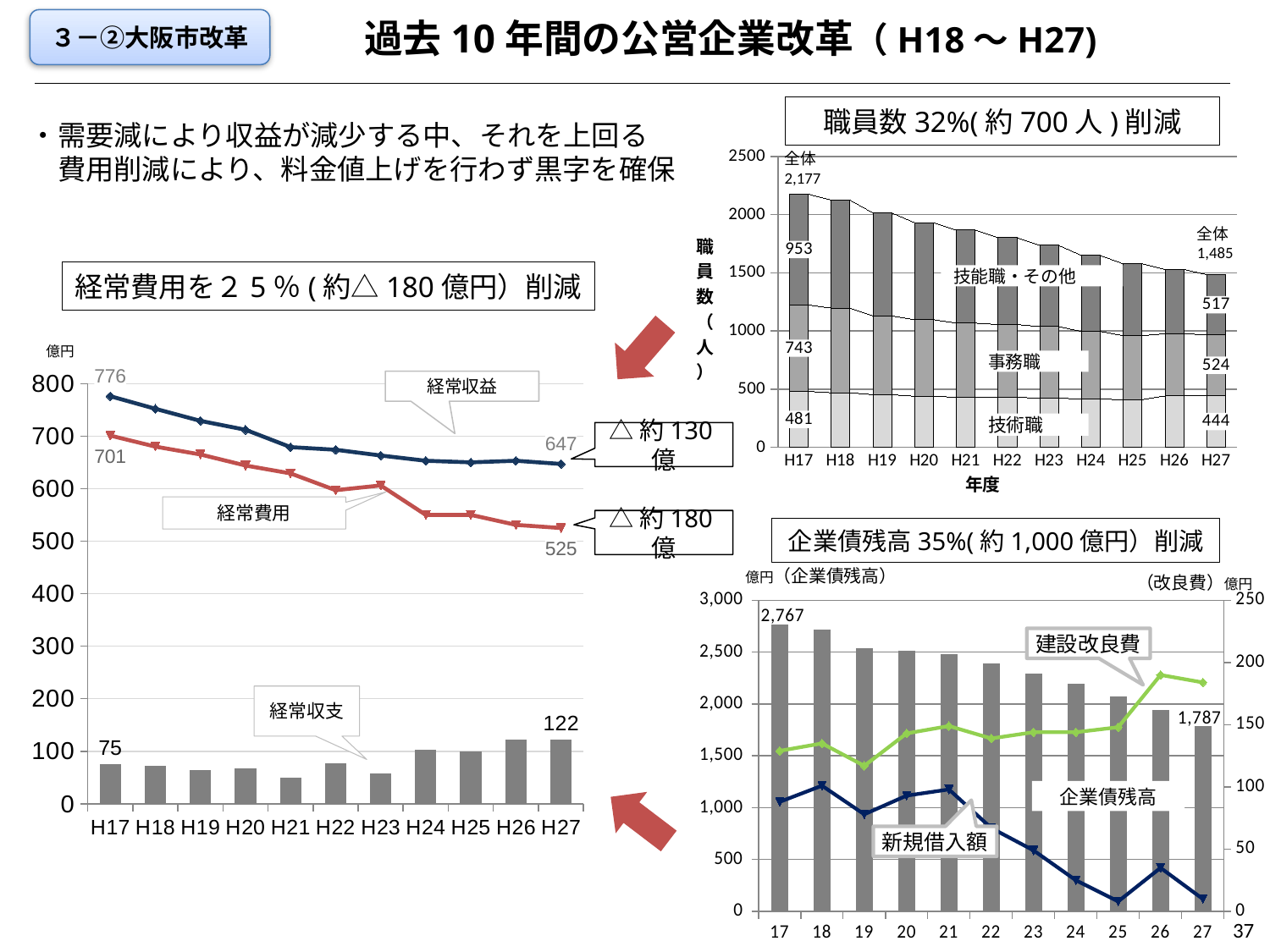
In the 経常費用を25%削減 chart on the left, what is the value of the 経常収支 bar in H27? 122 In the 企業債残高35%削減 chart at the bottom right, what is the 企業債残高 value for year 17? 2,767 In the 経常費用を25%削減 chart on the left, what is the value of 経常収益 in H17? 776 In the 職員数32%削減 chart at the top right, what is the 全体 total for H27? 1,485 In the 経常費用を25%削減 chart on the left, what is the value of 経常費用 in H27? 525 In the 職員数32%削減 chart at the top right, which is larger in H27, 事務職 or 技術職? 事務職 In the 経常費用を25%削減 chart on the left, how many fiscal years are shown on the x axis? 11 In the 企業債残高35%削減 chart at the bottom right, what is the difference between the 企業債残高 in year 17 (2,767) and year 27 (1,787)? 980 In the 経常費用を25%削減 chart on the left, does the 経常費用 line rise or fall from H17 to H27? fall In the 経常費用を25%削減 chart on the left, by how much did 経常収益 fall from H17 (776) to H27 (647)? 129 In the 職員数32%削減 chart at the top right, what is the value of 技能職・その他 in H17? 953 In the 経常費用を25%削減 chart on the left, is the 経常収支 bar for H21 greater or less than 100? less